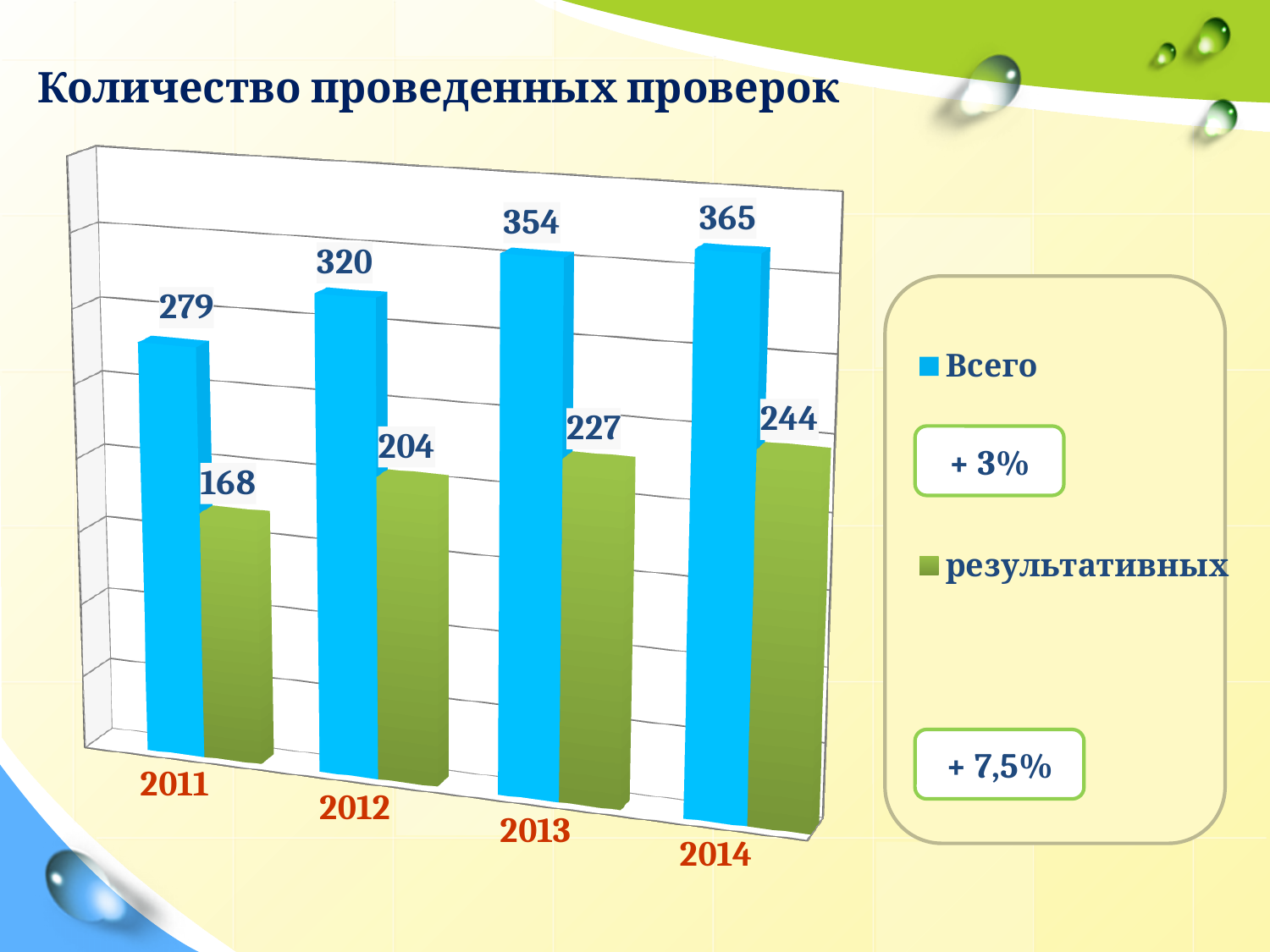
How many series does the legend list? 2 How many years are shown on the x axis? 4 What kind of chart is shown on the slide? bar chart What is the value of "результативных" for 2013? 227 What is the difference between "Всего" and "результативных" in 2012? 116 What is the value of "результативных" for 2011? 168 Which year has the highest value for "Всего"? 2014 What is the value of "Всего" for 2014? 365 Do the "Всего" values rise or fall from 2011 to 2014? rise Which year has the lowest value for "результативных"? 2011 Which is larger: "результативных" in 2014 or "результативных" in 2012? 2014 What is the difference between the "Всего" values for 2014 and 2011? 86